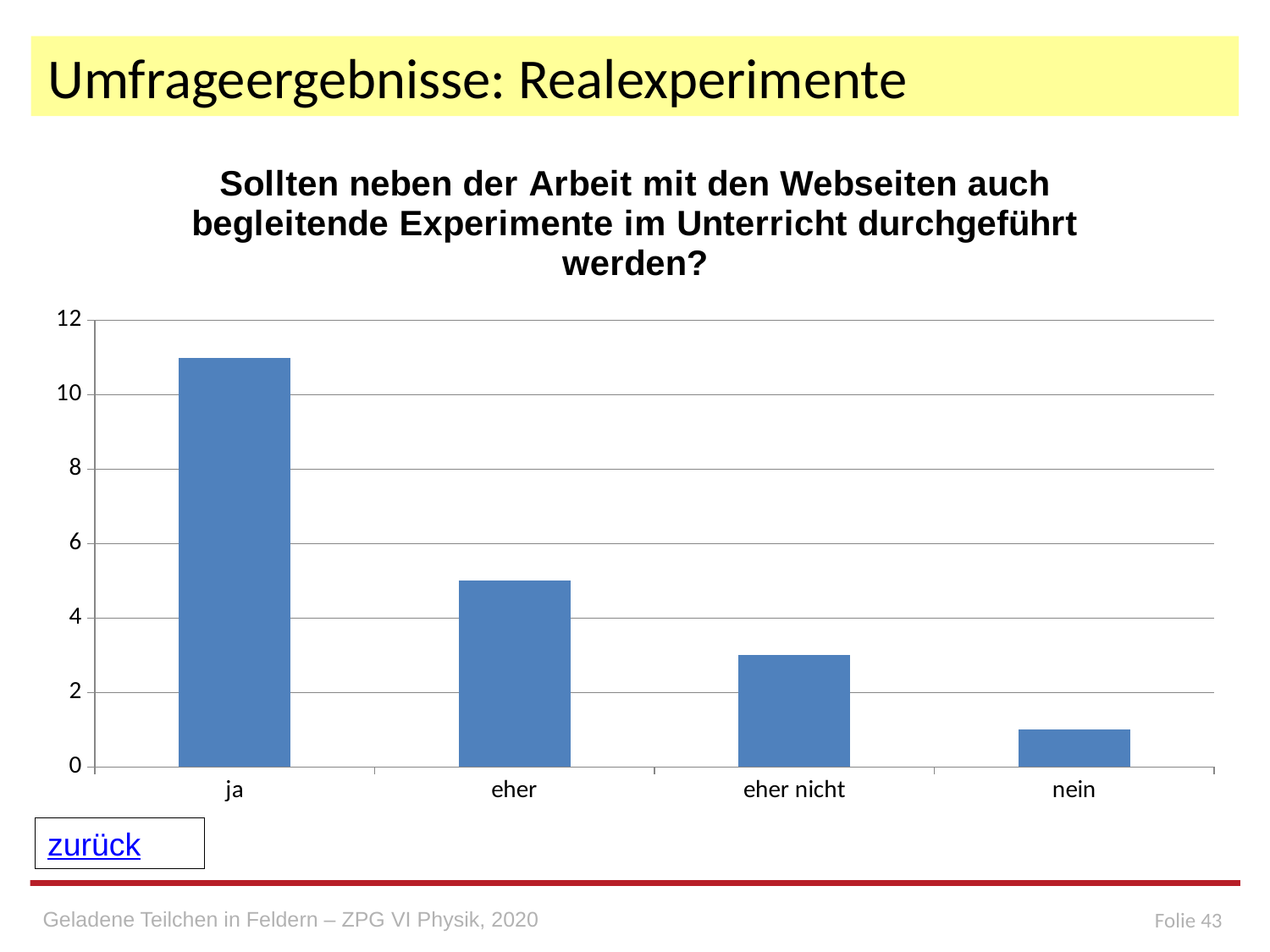
Is the value for "eher" greater or less than 4? greater Is the value for "eher nicht" greater or less than 4? less Do the bar values rise or fall from left to right along the x axis? fall Which is larger, the value for "eher" or the value for "eher nicht"? eher Which category has the lowest bar in the chart? nein What is the label of the third category on the x axis? eher nicht Is the value for "nein" greater or less than 2? less What is the highest value shown on the vertical axis of the chart? 12 What kind of chart is shown on the slide? bar chart Which category has the highest bar in the chart? ja How many categories are shown on the x axis of the chart? 4